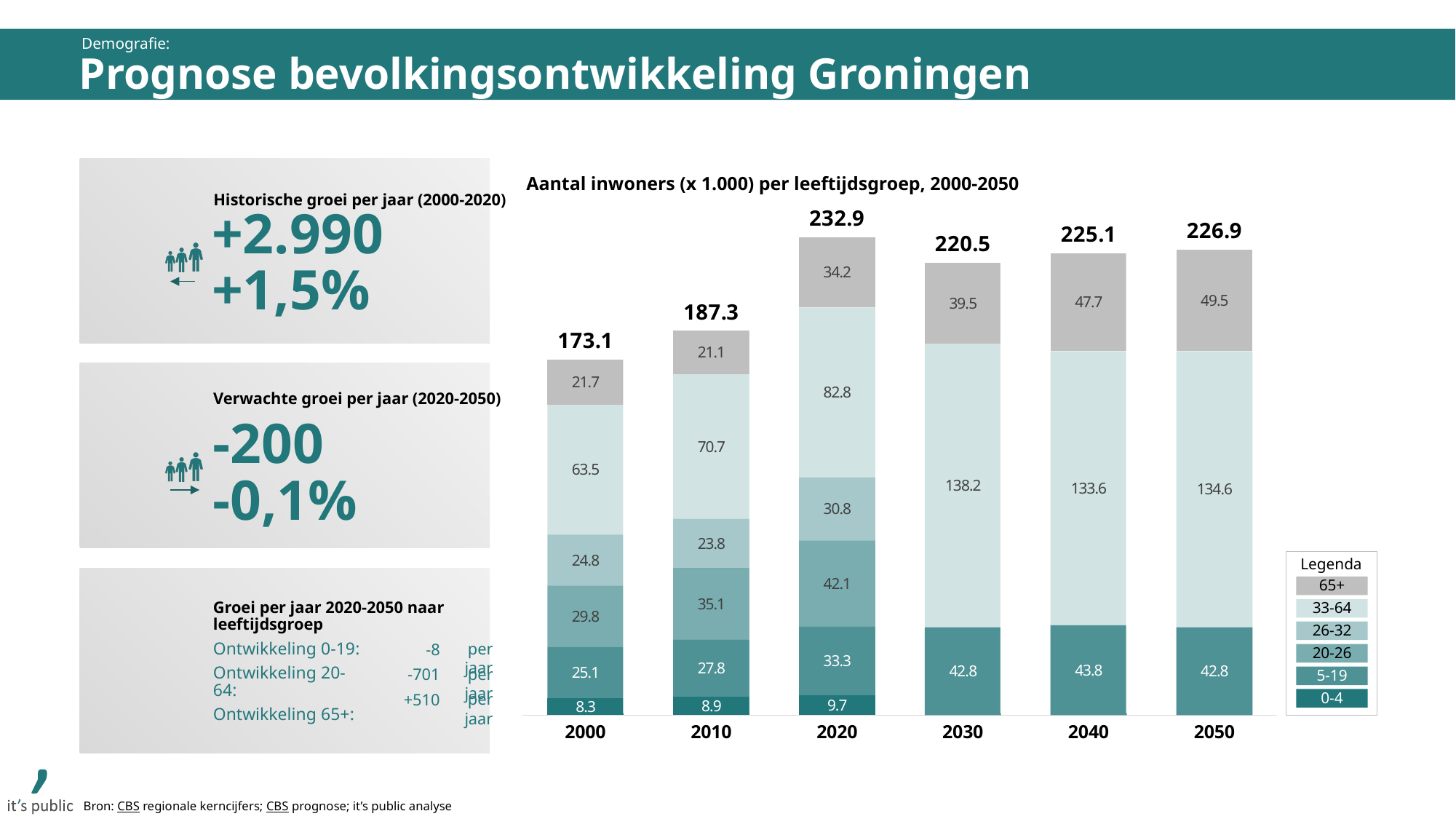
What is the value for the 26-32 age group in 2010? 23.8 What is the value for the 33-64 age group in 2030? 138.2 What is the value for the 0-4 age group in 2000? 8.3 Which year has a larger value for the 65+ age group, 2030 or 2040? 2040 What is the title of the chart? Aantal inwoners (x 1.000) per leeftijdsgroep, 2000-2050 Which year has the lowest total number of inhabitants in the chart? 2000 Which year has the highest total number of inhabitants in the chart? 2020 What is the difference between the total for 2020 and the total for 2000? 59.8 What is the value for the 65+ age group in 2050? 49.5 How many years are shown on the x axis of the chart? 6 How many age groups does the legend of the chart list? 6 What kind of chart is shown on the slide? Stacked bar chart